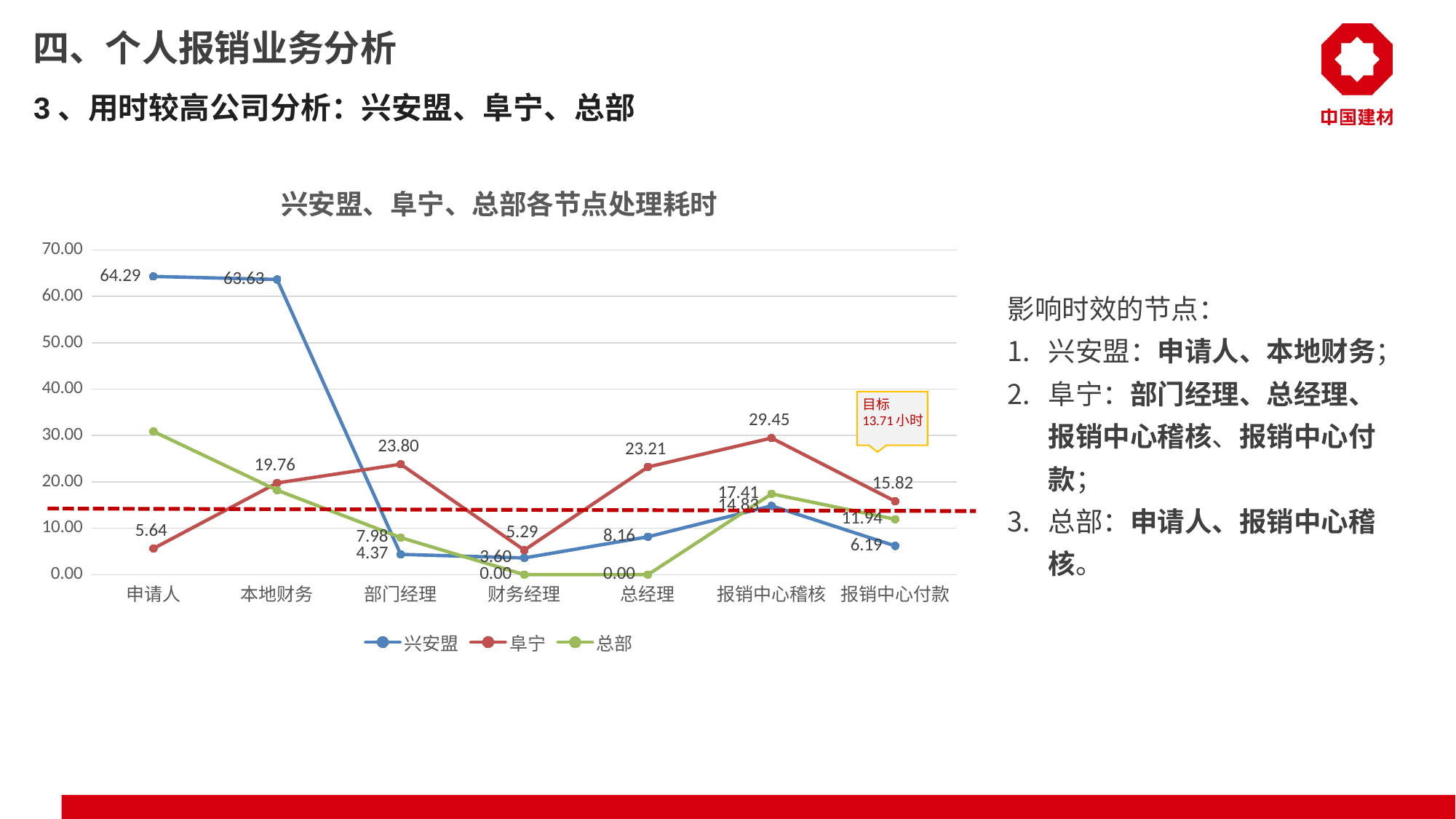
What is the difference between the 阜宁 values at 报销中心稽核 and 报销中心付款? 13.63 At the 总经理 node, which is larger: 阜宁 or 兴安盟? 阜宁 Is the value for 总部 at the 申请人 node greater or less than 20.00? greater At which node does 兴安盟 have its lowest value? 财务经理 What is the value for 总部 at the 报销中心付款 node? 11.94 How many nodes are shown on the x axis? 7 How many series does the legend list? 3 At which node does 阜宁 have its highest value? 报销中心稽核 What kind of chart is shown on the slide? line chart What target value is shown in the callout next to the dashed line? 13.71 小时 What is the value for 兴安盟 at the 申请人 node? 64.29 What is the value for 阜宁 at the 报销中心稽核 node? 29.45